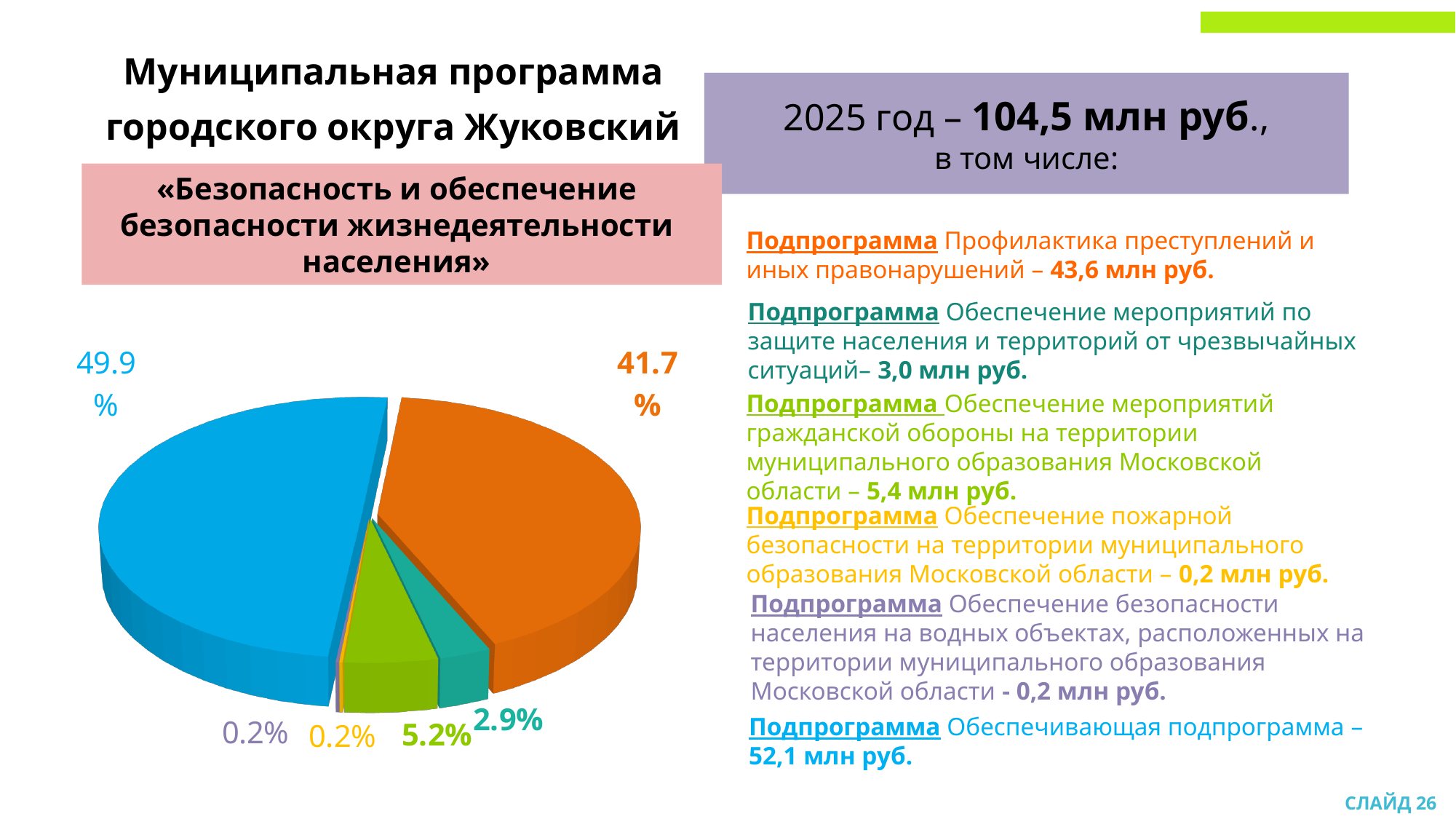
Which slice is larger, the green slice or the teal slice? Green (5.2%) What percentage is shown for the orange slice of the pie chart? 41.7% How many slices does the pie chart have? 6 What percentage is shown for the blue slice of the pie chart? 49.9% What kind of chart is shown on the slide? Pie chart Which colour slice is the largest in the pie chart? Blue (49.9%) What is the combined share of the blue and orange slices? 91.6% What percentage is shown for the green slice of the pie chart? 5.2% What percentage is shown for the teal slice of the pie chart? 2.9% What is the difference in percentage points between the blue slice and the orange slice? 8.2 What is the smallest percentage labelled on the pie chart? 0.2% How many slices of the pie chart are labelled 0.2%? 2